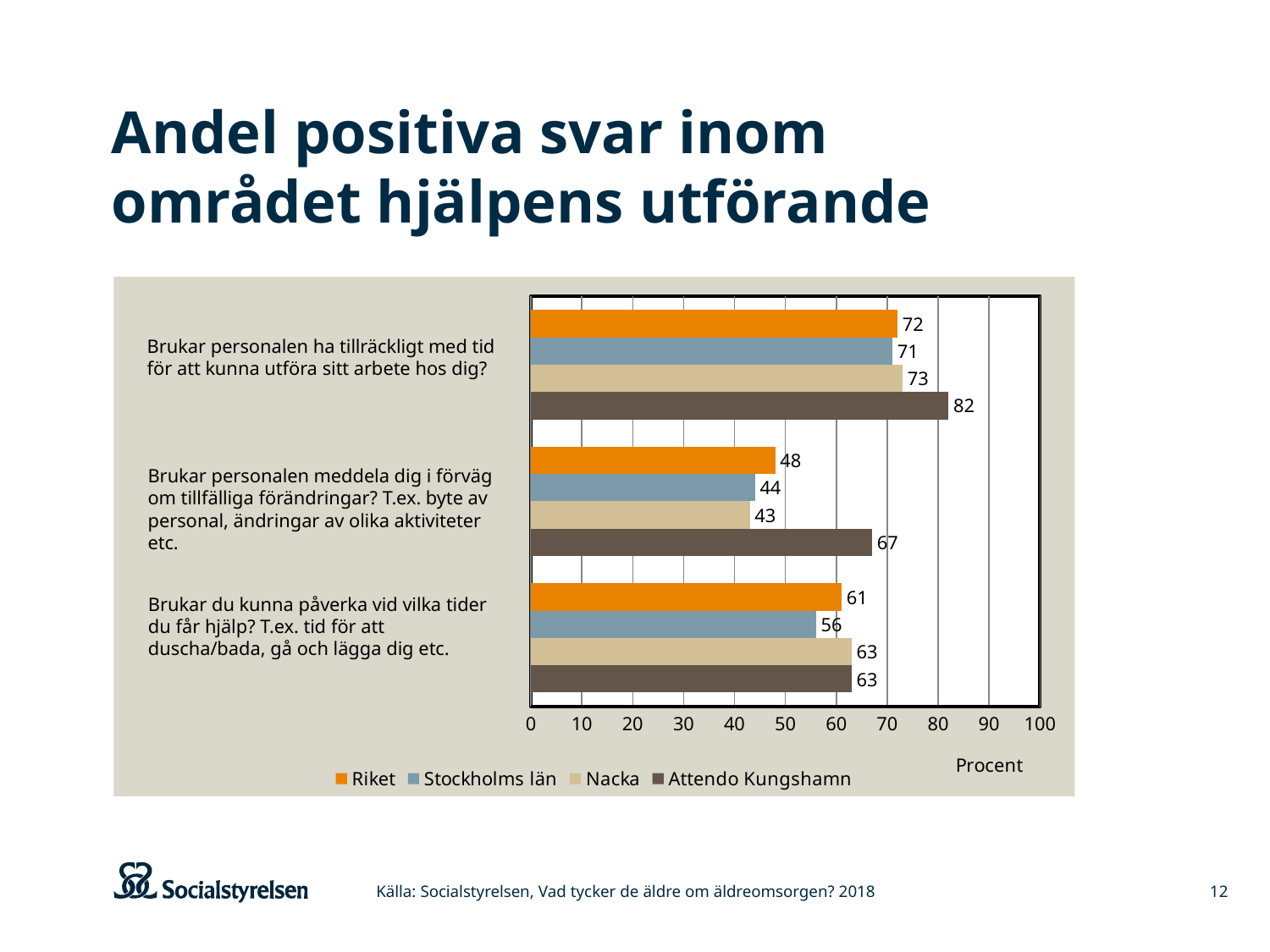
Which series has the highest value on the question "Brukar personalen meddela dig i förväg om tillfälliga förändringar?" Attendo Kungshamn Is the value for Attendo Kungshamn on the question "Brukar personalen ha tillräckligt med tid" greater or less than 80? greater What is the value for Attendo Kungshamn on the question "Brukar personalen ha tillräckligt med tid för att kunna utföra sitt arbete hos dig?" 82 What is the difference between Attendo Kungshamn and Riket on the question "Brukar personalen meddela dig i förväg om tillfälliga förändringar?" 19 How many questions (categories) are shown on the chart? 3 Which is larger on the question "Brukar personalen ha tillräckligt med tid för att kunna utföra sitt arbete hos dig?": Riket or Nacka? Nacka How many series does the legend list? 4 What is the value for Stockholms län on the question "Brukar du kunna påverka vid vilka tider du får hjälp?" 56 Which series has the lowest value on the question "Brukar du kunna påverka vid vilka tider du får hjälp?" Stockholms län What kind of chart is shown on the slide? Bar chart What is the label of the horizontal axis? Procent What is the value for Nacka on the question "Brukar personalen meddela dig i förväg om tillfälliga förändringar?" 43